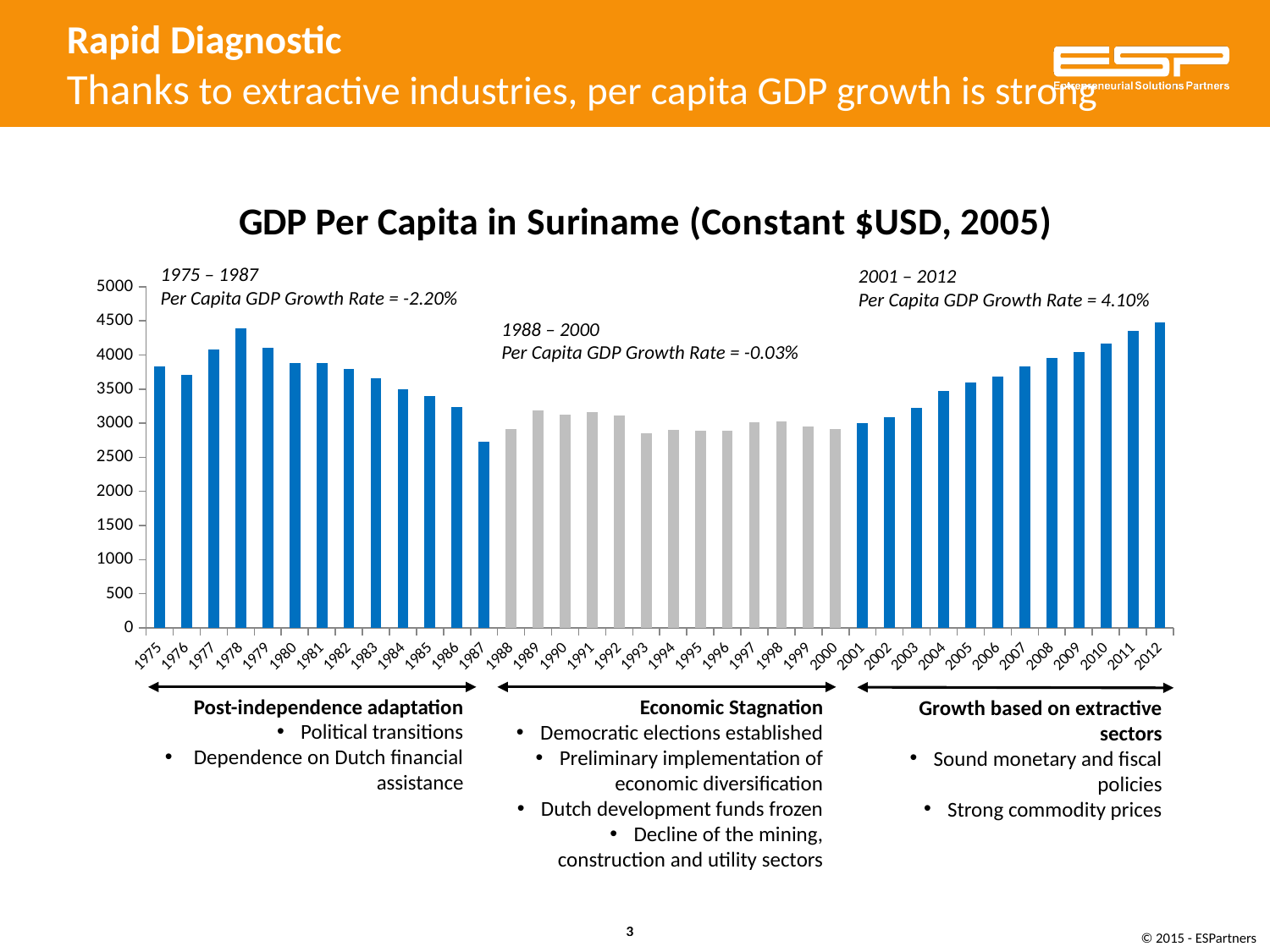
What is the title of the chart? GDP Per Capita in Suriname (Constant $USD, 2005) Is the value for 1987 greater or less than 3000? less How many years (bars) are plotted on the chart? 38 Is the value for 2012 greater or less than 4000? greater Do the values rise or fall from 2001 to 2012? rise Which year has the lowest GDP per capita on the chart? 1987 Which year has the larger GDP per capita, 1978 or 1987? 1978 Is the value for 1993 greater or less than 3000? less What per capita GDP growth rate is annotated for the 2001 – 2012 period? 4.10% Which year has the larger GDP per capita, 2012 or 1988? 2012 What kind of chart is shown on the slide? Bar chart